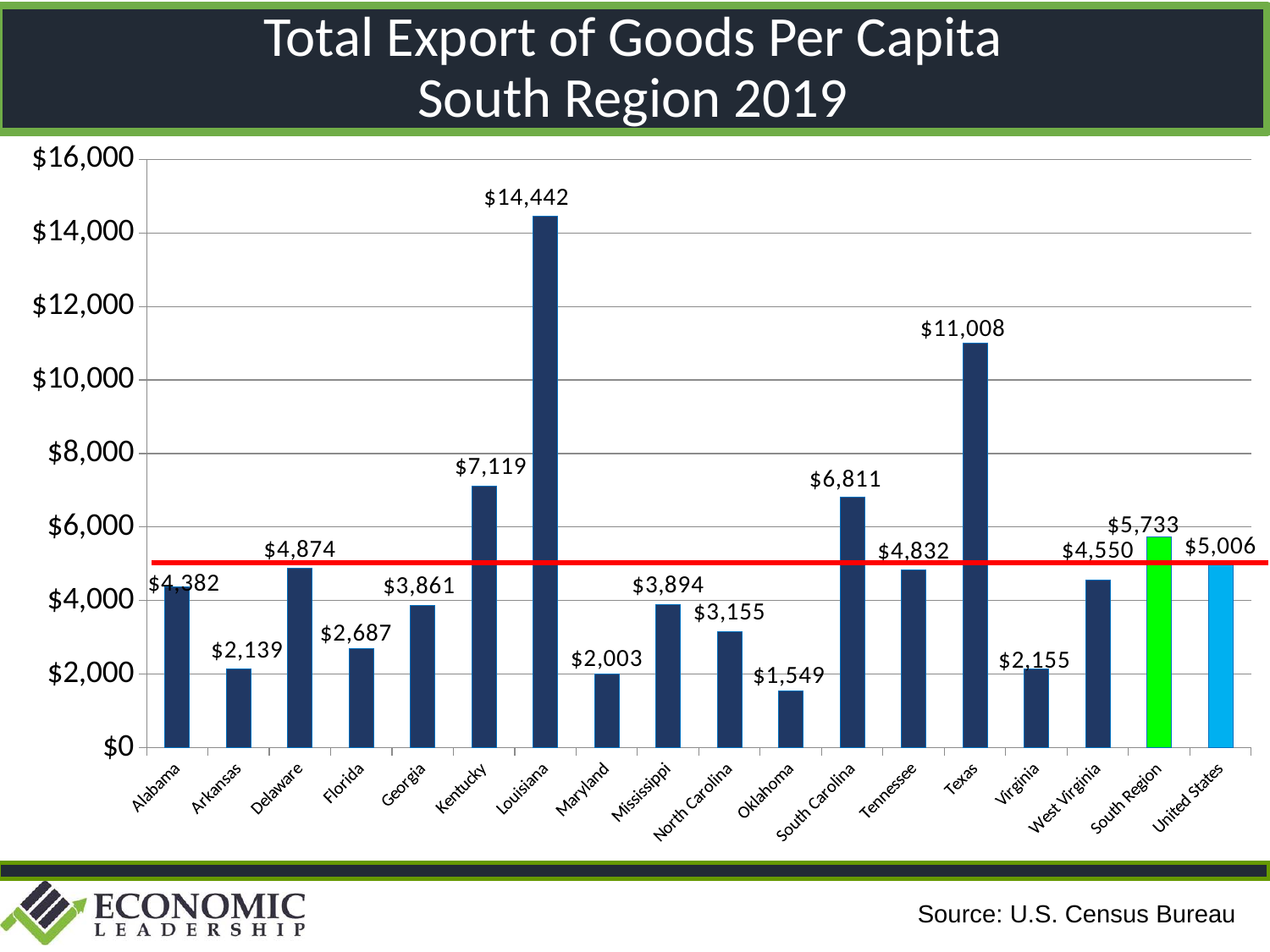
What is the total export of goods per capita for Louisiana? $14,442 What kind of chart is shown on the slide? Bar chart Which has a higher export of goods per capita, Kentucky or South Carolina? Kentucky What is the export of goods per capita for Oklahoma? $1,549 What is the export of goods per capita for the South Region? $5,733 What colour is the bar for the South Region? Green How much higher is the South Region value than the United States value? $727 What is the difference between Louisiana's and Texas's export of goods per capita? $3,434 How many categories are shown on the x axis? 18 Which category has the highest export of goods per capita? Louisiana Is the value for Texas greater or less than $10,000? greater Which category has the lowest export of goods per capita? Oklahoma